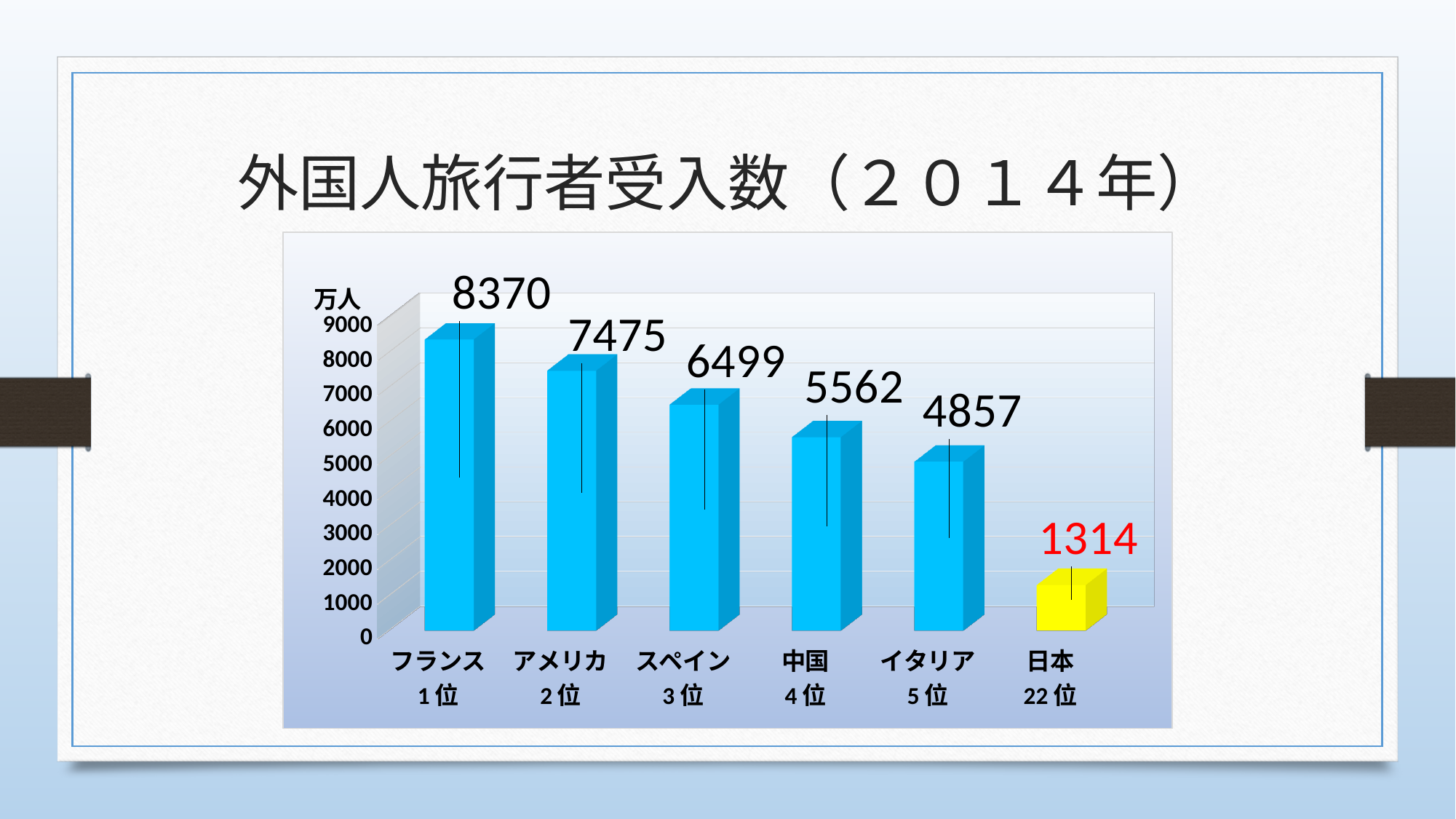
What is the value for 中国 (China)? 5562 Which country has the lowest value? 日本 What is the title of the chart on the slide? 外国人旅行者受入数（２０１４年） What kind of chart is shown on the slide? bar chart What is the value for 日本 (Japan)? 1314 Which is larger, the value for イタリア or the value for 中国? 中国 What is the difference between the values for フランス and 日本? 7056 Do the values rise or fall from left to right along the x axis? fall What is the value for フランス (France)? 8370 Which country has the highest value? フランス What is the difference between the values for アメリカ and スペイン? 976 How many countries are shown in the chart? 6